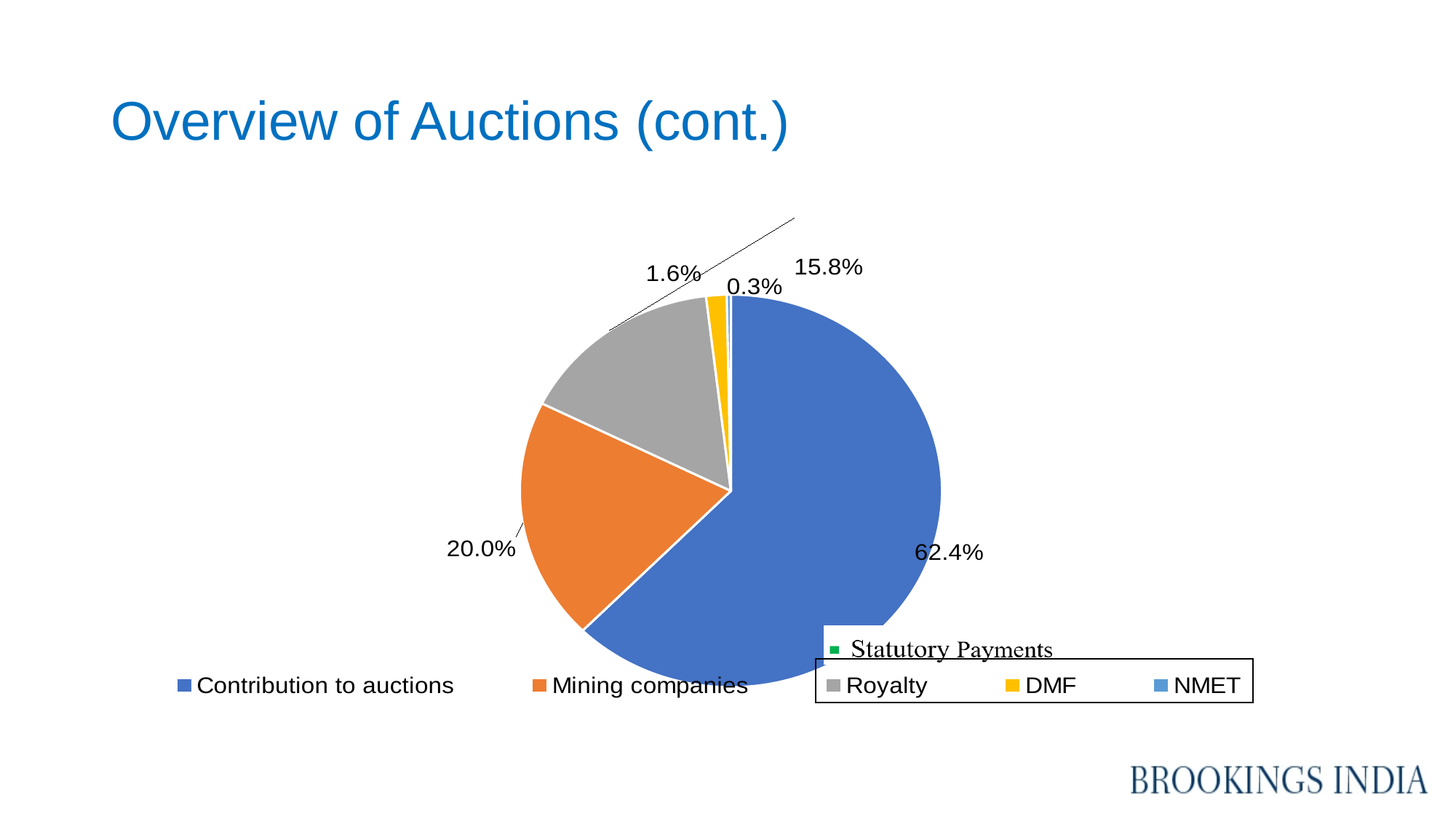
Which is larger, the Royalty slice or the DMF slice? Royalty What share of the pie does Royalty represent? 15.8% What share of the pie does Contribution to auctions represent? 62.4% What type of chart is shown on the slide? pie chart What colour is the slice for Mining companies? orange What share of the pie does Mining companies represent? 20.0% Which category has the smallest slice of the pie? NMET Which category has the largest slice of the pie? Contribution to auctions What is the difference in percentage points between Mining companies and Royalty? 4.2% What is the difference in percentage points between Contribution to auctions and Mining companies? 42.4%